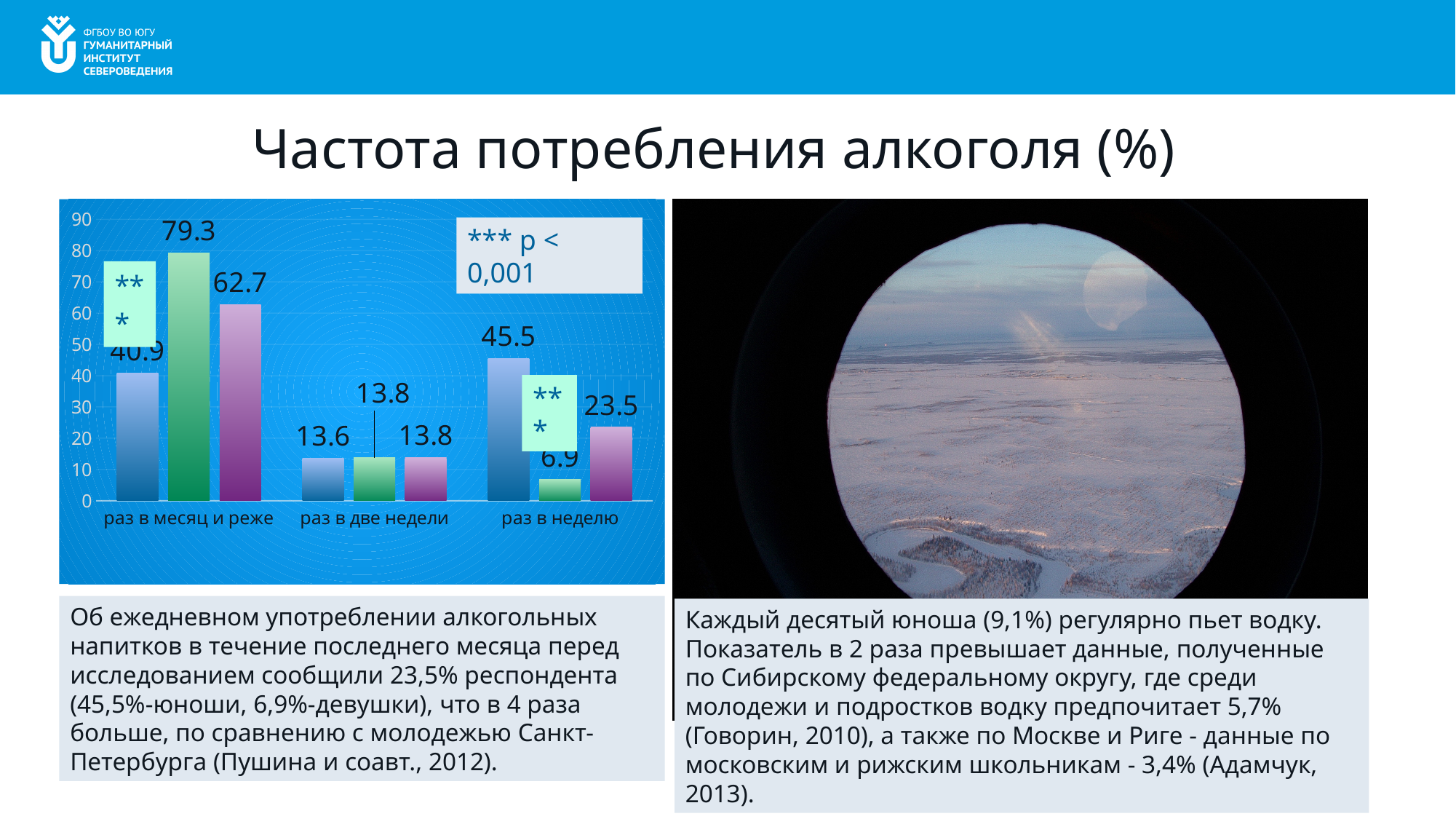
What is the value of the purple bar for "раз в неделю"? 23.5 What is the difference between the green bar (79.3) and the blue bar (40.9) for "раз в месяц и реже"? 38.4 For "раз в неделю", which is larger: the blue bar or the purple bar? the blue bar What is the value of the blue bar for "раз в две недели"? 13.6 What kind of chart is shown on the slide? bar chart How many categories are shown on the x axis of the chart? 3 What is the value of the green bar for "раз в неделю"? 6.9 Which category has the highest green bar? раз в месяц и реже What is the value of the blue bar for "раз в неделю"? 45.5 Which category has the lowest green bar? раз в неделю What is the value of the green bar for "раз в месяц и реже"? 79.3 What significance note is shown in the box at the top right of the chart? *** p < 0,001